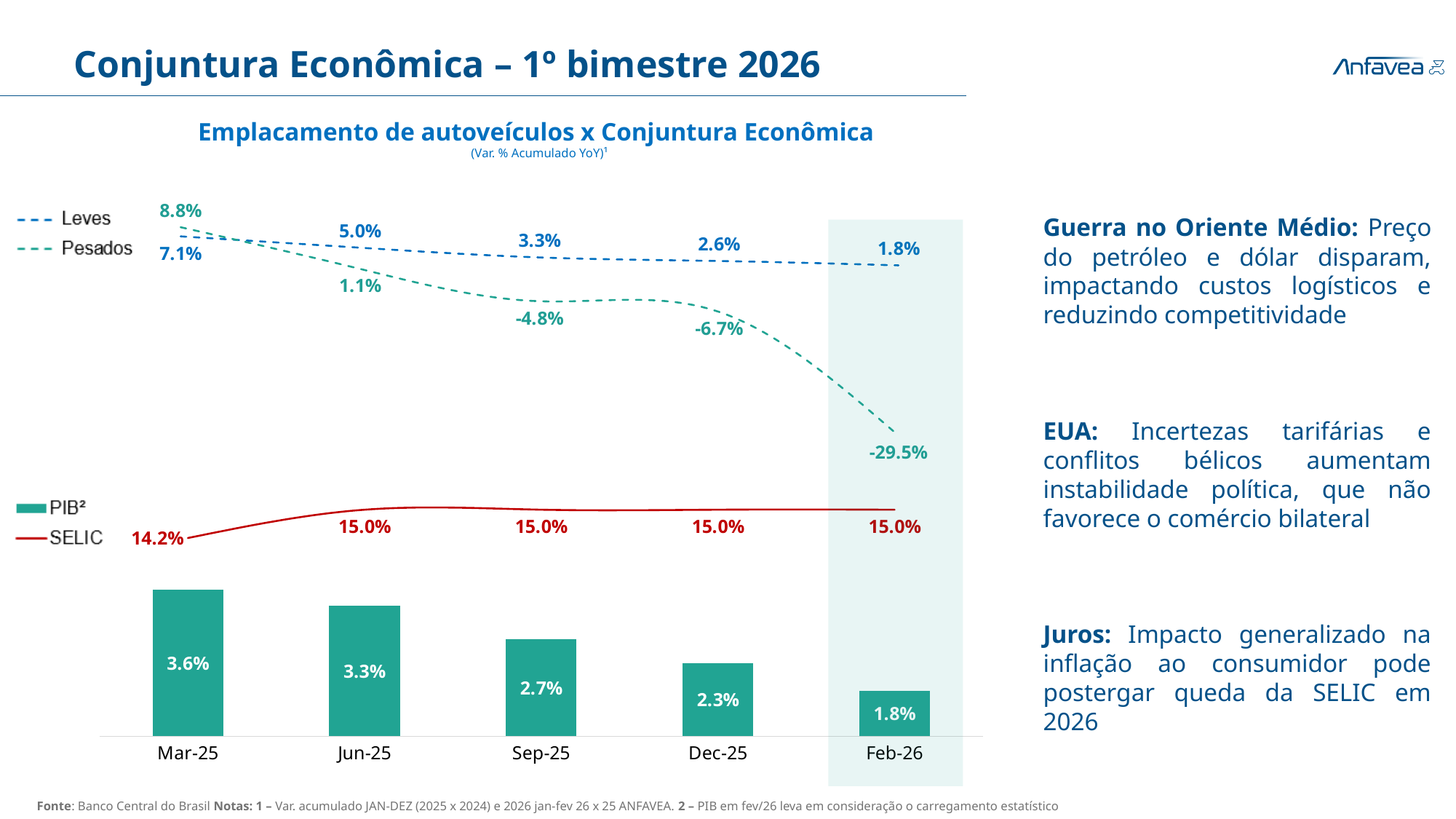
What is the difference between the PIB values for Mar-25 and Feb-26? 1.8% What is the SELIC value for Mar-25? 14.2% What is the PIB value for Sep-25? 2.7% In which period is the Pesados value lowest? Feb-26 How many series does the legend list? 4 Which is larger in Mar-25, the Leves value or the Pesados value? Pesados What is the Pesados value for Feb-26? -29.5% What is the Leves value for Jun-25? 5.0% Do the PIB bars rise or fall from Mar-25 to Feb-26? fall How many periods are shown on the x axis? 5 Which series is drawn as a solid red line? SELIC In which period is the PIB bar highest? Mar-25